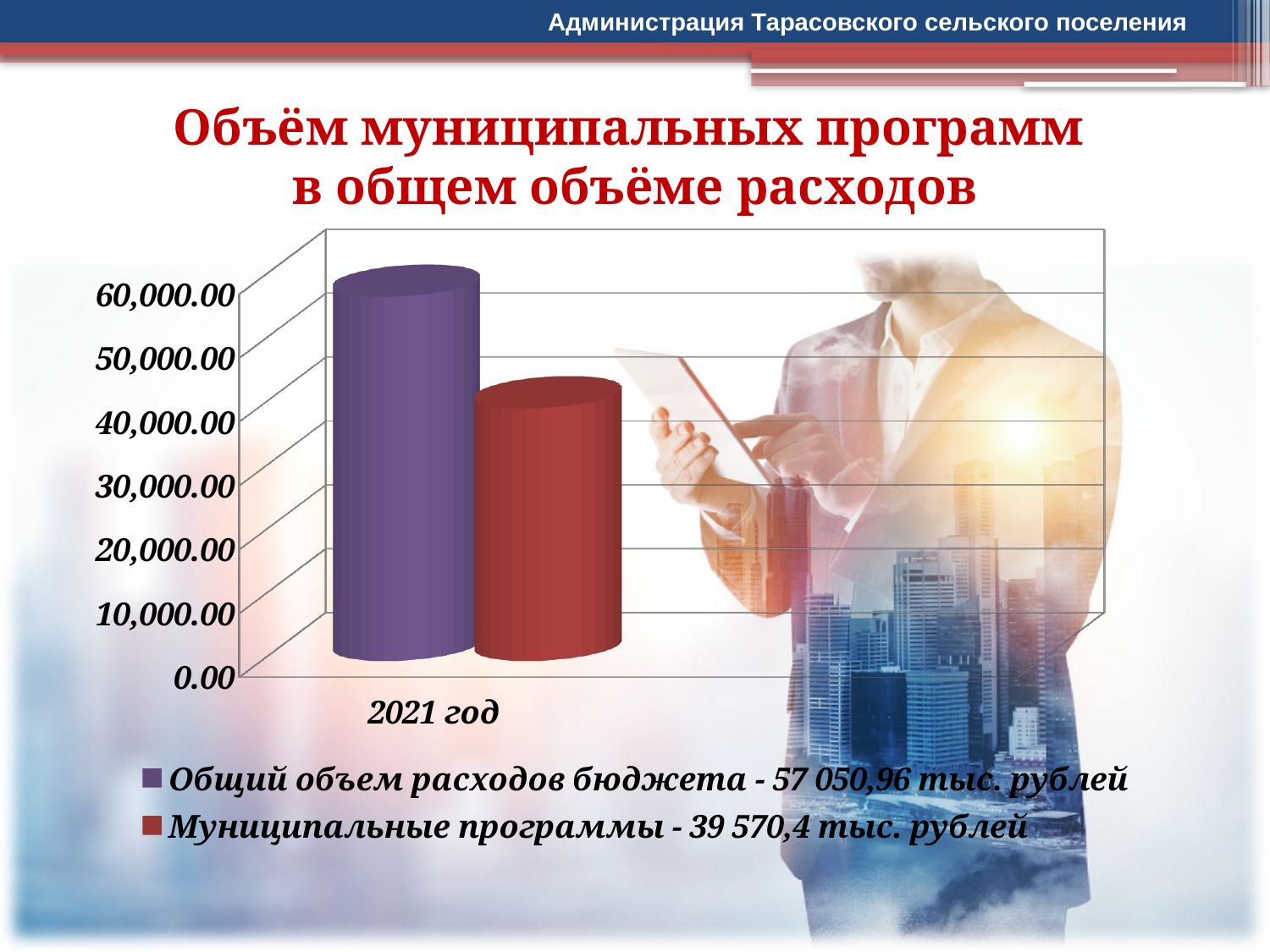
How many categories are shown on the x axis? 1 Which series has the lowest value in the chart? Муниципальные программы What type of chart is shown on the slide? bar chart Which series has the higher value: Общий объем расходов бюджета or Муниципальные программы? Общий объем расходов бюджета What is the value of the total budget expenditure (Общий объем расходов бюджета) according to the legend? 57 050,96 тыс. рублей What is the title of the chart? Объём муниципальных программ в общем объёме расходов What is the difference between the total budget expenditure and the municipal programmes value? 17 480,56 тыс. рублей How many series does the legend list? 2 Which year is shown on the x axis of the chart? 2021 год What colour is the bar for Общий объем расходов бюджета? purple What is the value of municipal programmes (Муниципальные программы) according to the legend? 39 570,4 тыс. рублей Is the value for Муниципальные программы greater or less than 50,000.00? less